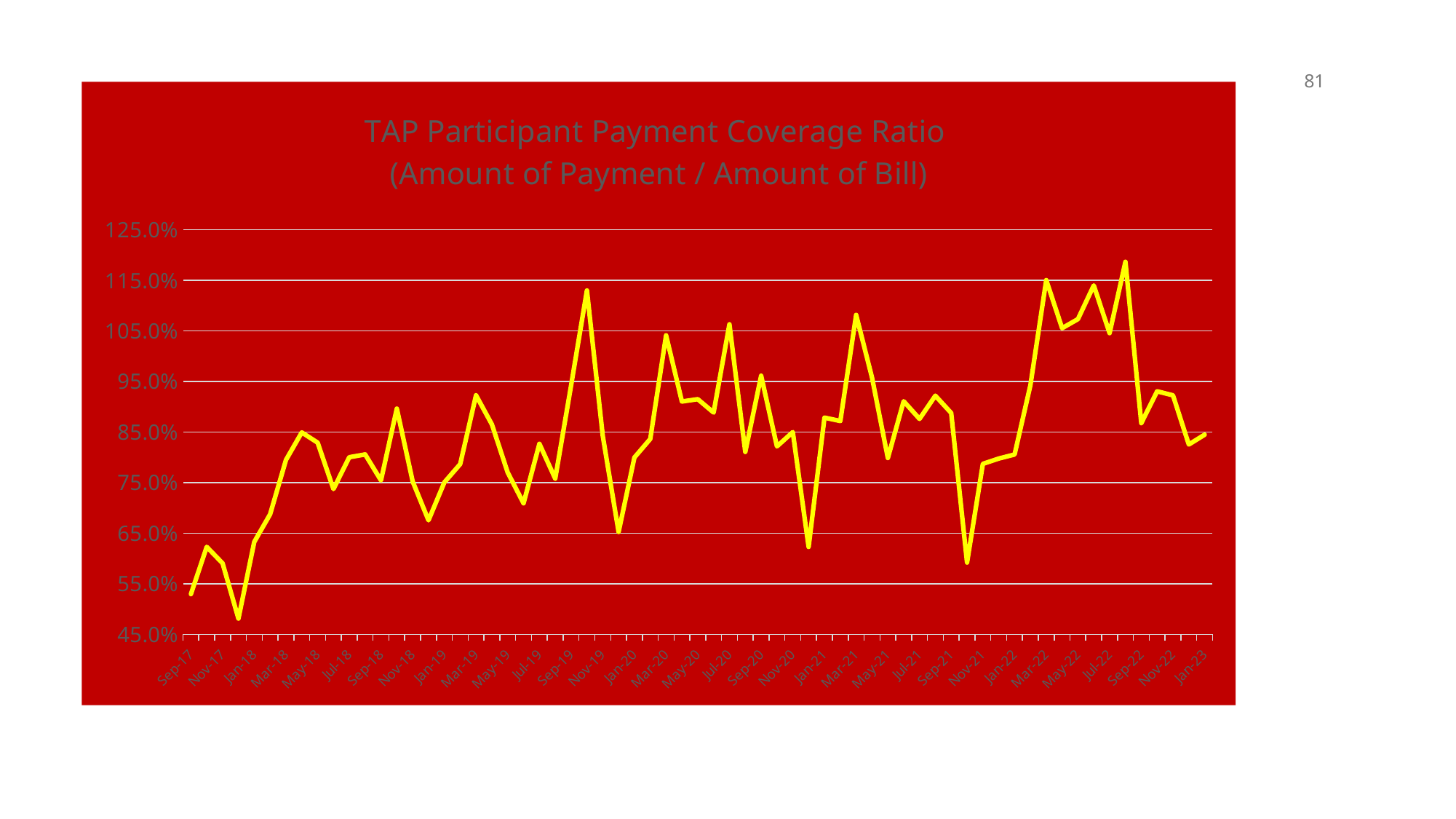
Is the value for Nov-22 greater or less than 85.0%? greater Is the value for Mar-19 greater or less than 85.0%? greater Is the value for Mar-22 greater or less than 105.0%? greater What is the title of the chart? TAP Participant Payment Coverage Ratio (Amount of Payment / Amount of Bill) Which is larger, the value for Mar-22 or the value for Sep-17? Mar-22 What colour is the plotted line? yellow Overall, does the payment coverage ratio rise or fall from Sep-17 to Jan-23? rise What kind of chart is shown on the slide? line chart